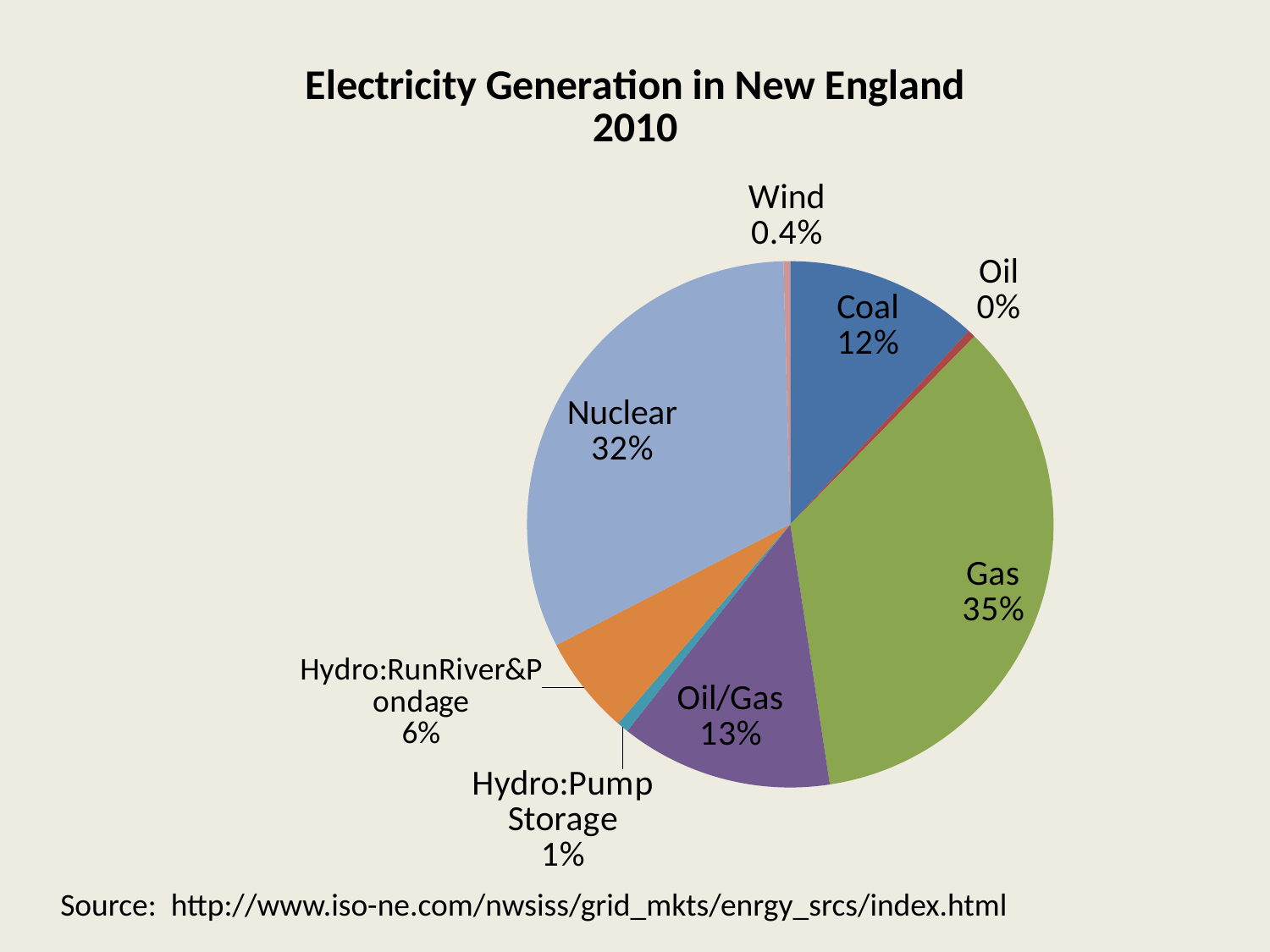
What is the difference in percentage points between Gas and Nuclear? 3 How many categories are shown in the pie chart? 8 What is the value shown for Wind? 0.4% Which source has the smallest labelled share? Oil Which source has the largest share of electricity generation? Gas Which is larger, the share for Oil/Gas or the share for Hydro:RunRiver&Pondage? Oil/Gas What share of electricity generation does Gas account for? 35% What is the difference in percentage points between Oil/Gas and Coal? 1 What is the value shown for Hydro:Pump Storage? 1% What kind of chart is shown on the slide? Pie chart What is the value shown for Coal? 12% What share of electricity generation does Nuclear account for? 32%